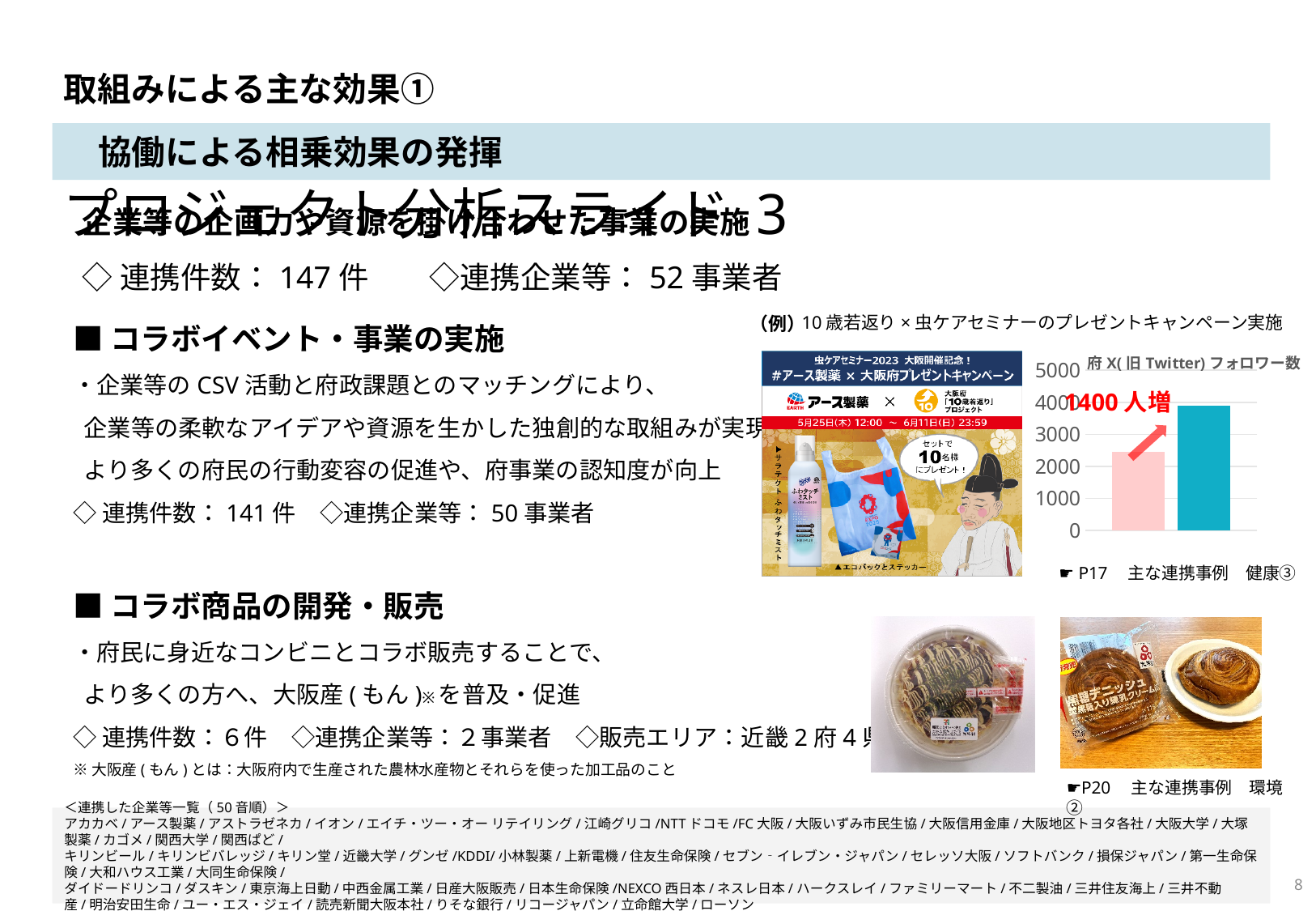
In the '府X(旧Twitter)フォロワー数' chart, is the value of the teal right bar greater or less than 3000? greater In the '府X(旧Twitter)フォロワー数' chart, which bar is taller, the pink left bar or the teal right bar? the teal right bar In the '府X(旧Twitter)フォロワー数' chart, is the value of the pink left bar greater or less than 3000? less How many bars does the '府X(旧Twitter)フォロワー数' chart show? 2 What is the highest value shown on the vertical axis of the '府X(旧Twitter)フォロワー数' chart? 5000 Do the values in the '府X(旧Twitter)フォロワー数' chart rise or fall from left to right? rise What kind of chart is shown next to the text '府X(旧Twitter)フォロワー数'? bar chart In the '府X(旧Twitter)フォロワー数' chart, is the value of the pink left bar greater or less than 2000? greater What increase in followers is annotated on the '府X(旧Twitter)フォロワー数' chart? 1400人増 What is the title of the bar chart on the right side of the slide? 府X(旧Twitter)フォロワー数